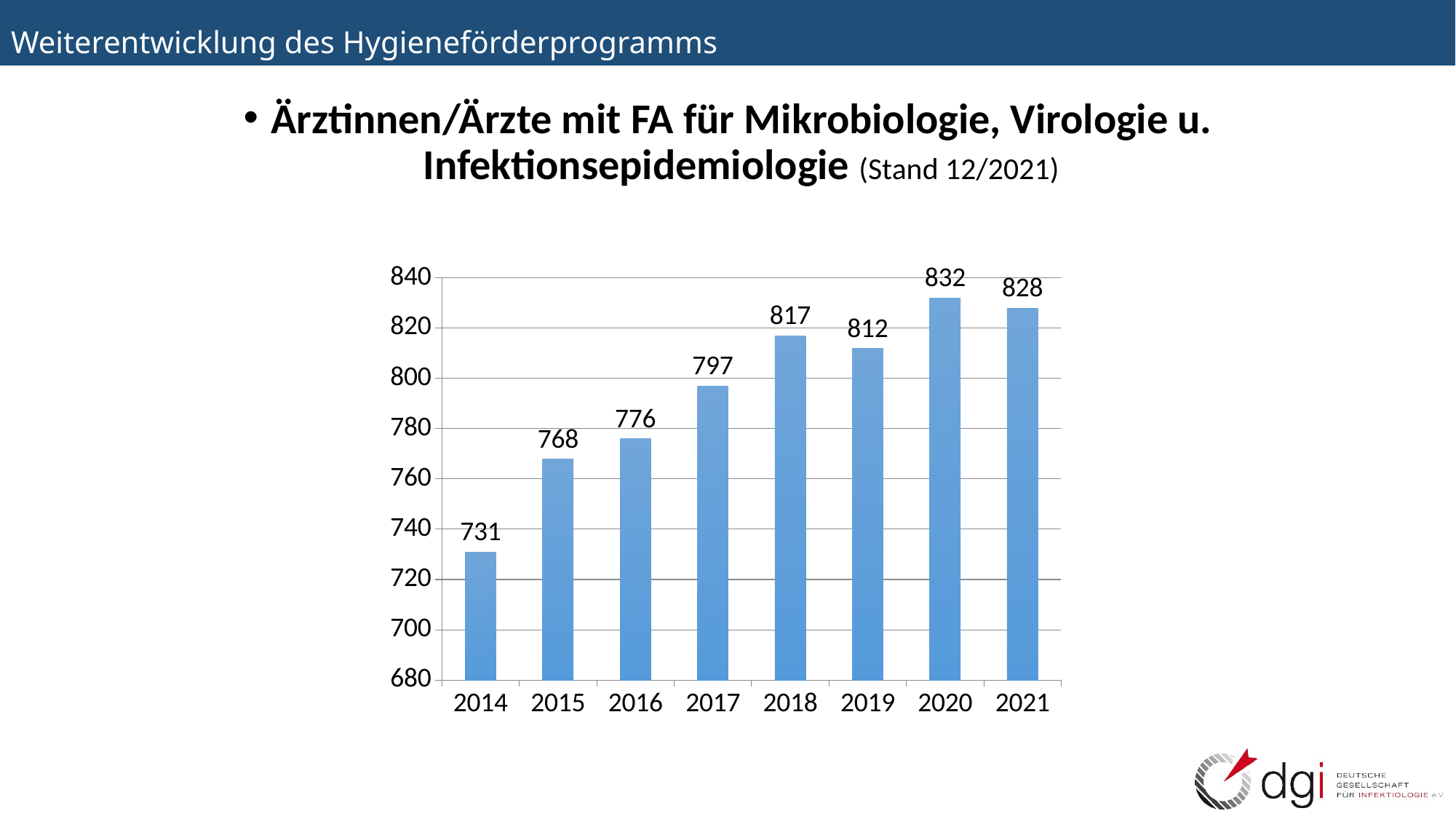
What is the difference between the values for 2020 and 2014? 101 How many years are shown on the x axis? 8 Is the value for 2015 greater or less than 760? greater What kind of chart is shown on the slide? bar chart What is the value for 2014? 731 What is the difference between the values for 2017 and 2016? 21 Do the values generally rise or fall from 2014 to 2020? rise What is the value for 2018? 817 What is the value for 2021? 828 Which year has the lowest value? 2014 Which year has the highest value? 2020 Which is larger, the value for 2019 or the value for 2018? 2018